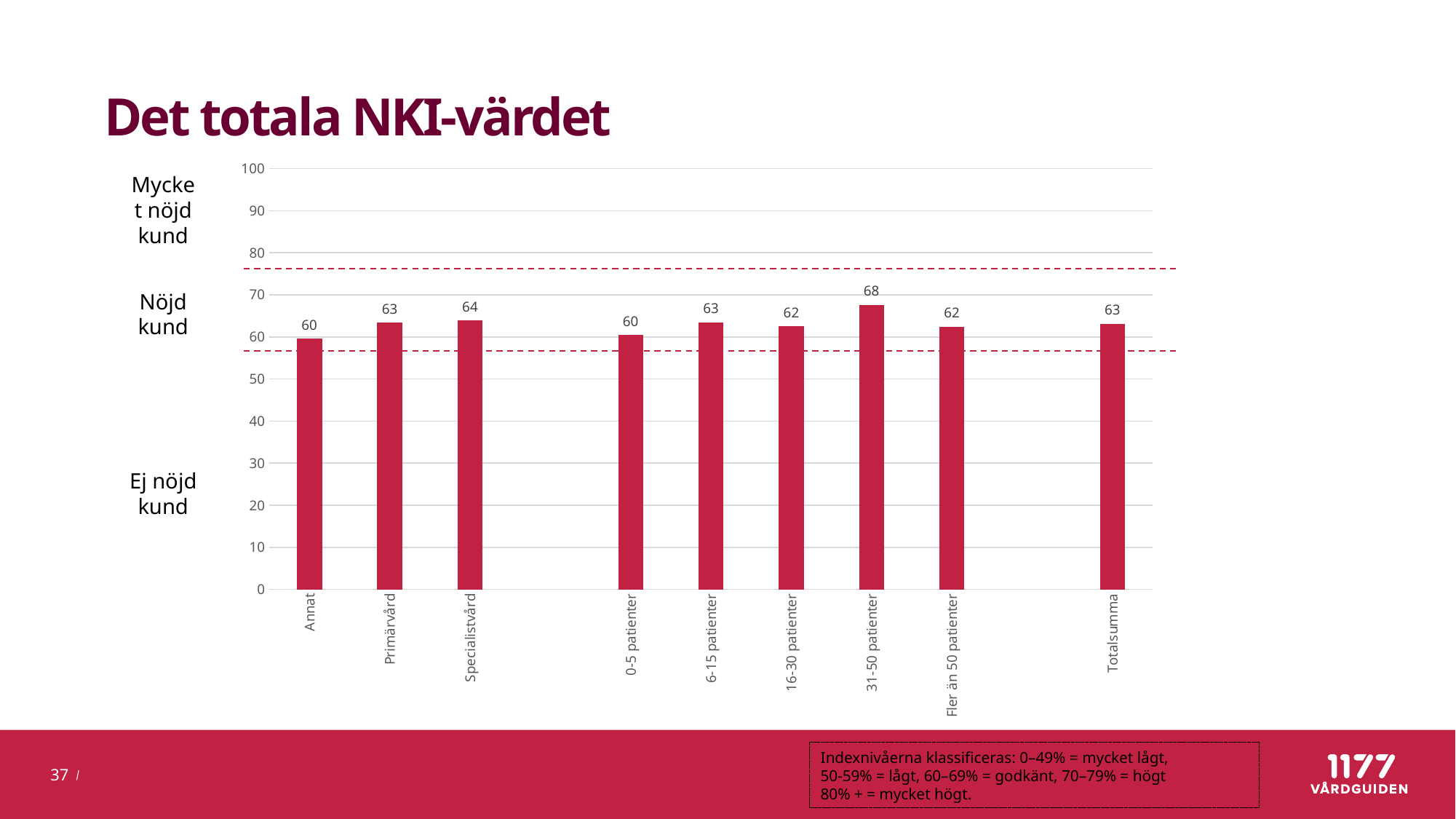
What is the value for Specialistvård? 64 Is the value for Fler än 50 patienter greater or less than 70? less Which category has the highest value? 31-50 patienter What is the value for 31-50 patienter? 68 What is the value for Annat? 60 What is the value for Totalsumma? 63 What kind of chart is shown on the slide? bar chart Which is larger, the value for Primärvård or the value for Specialistvård? Specialistvård What is the difference between the values for 31-50 patienter and Annat? 8 What is the title of the slide? Det totala NKI-värdet How many bars are shown in the chart? 9 What is the value for 16-30 patienter? 62